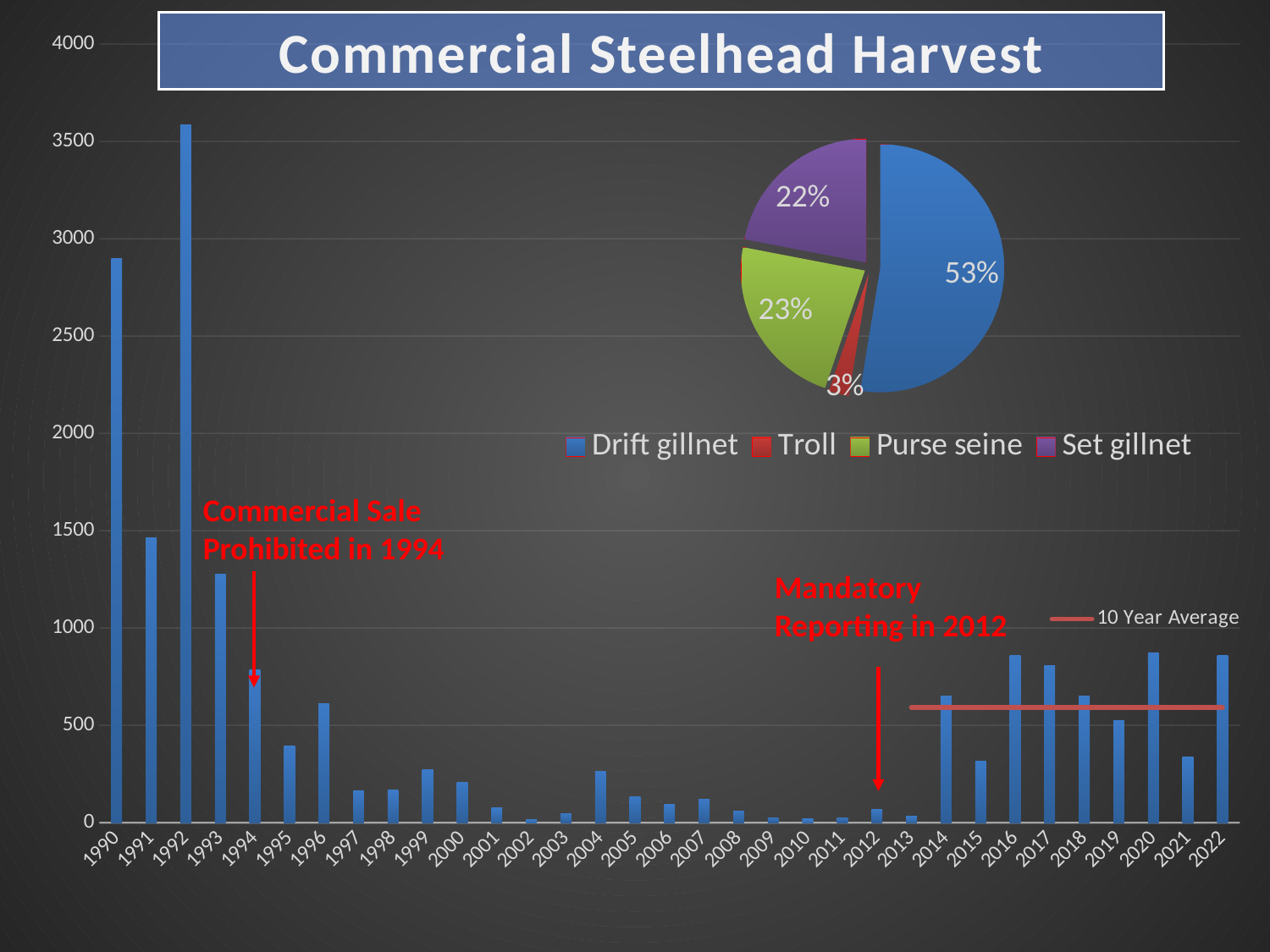
In the bar chart titled Commercial Steelhead Harvest, is the value for 2016 greater or less than 1000? less In the pie chart, which gear type has the smallest share? Troll In the pie chart, how many gear types does the legend list? 4 In the bar chart titled Commercial Steelhead Harvest, which year has the highest harvest? 1992 In the pie chart, what share does Purse seine account for? 23% What kind of chart shows the Commercial Steelhead Harvest by year? Bar chart In the bar chart titled Commercial Steelhead Harvest, is the value for 1990 greater or less than 2500? greater In the pie chart, which gear type has the largest share? Drift gillnet In the pie chart, what share does Troll account for? 3% In the pie chart, what share does Drift gillnet account for? 53% In the pie chart, what is the difference in percentage points between the Drift gillnet share and the Set gillnet share? 31 In the bar chart titled Commercial Steelhead Harvest, which year has the larger harvest, 1991 or 1993? 1991